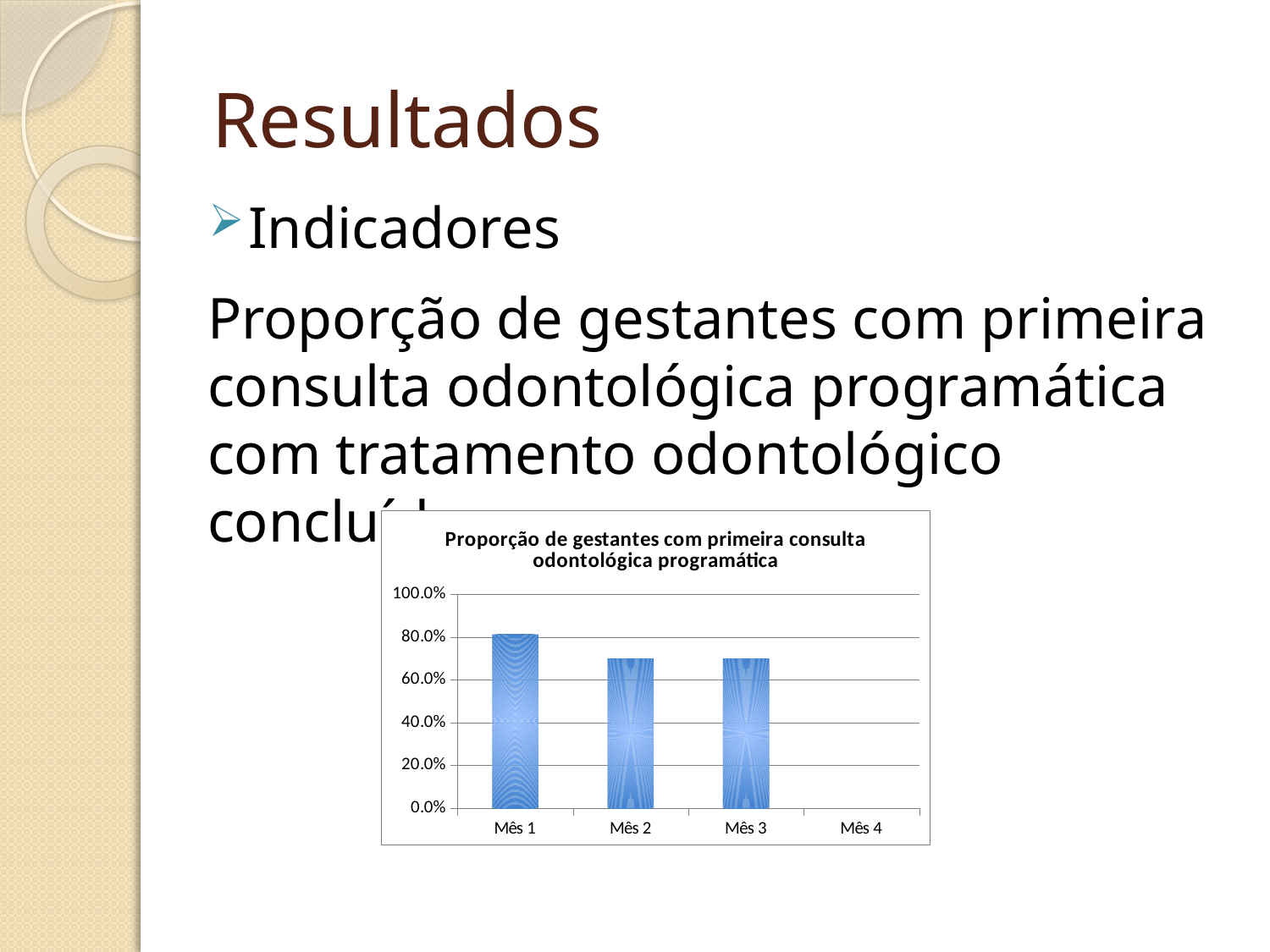
Is the value for Mês 3 greater or less than 80.0%? less Does the value rise or fall from Mês 1 to Mês 2? fall What is the highest tick value shown on the y axis of the chart? 100.0% What kind of chart is shown on the slide? bar chart Is the value for Mês 1 greater or less than 60.0%? greater Which category on the x axis has no visible bar? Mês 4 What is the title of the chart? Proporção de gestantes com primeira consulta odontológica programática How many categories are shown on the x axis of the chart? 4 Which month has the highest value in the chart? Mês 1 Which is larger, the value for Mês 1 or the value for Mês 2? Mês 1 Is the value for Mês 2 greater or less than 60.0%? greater